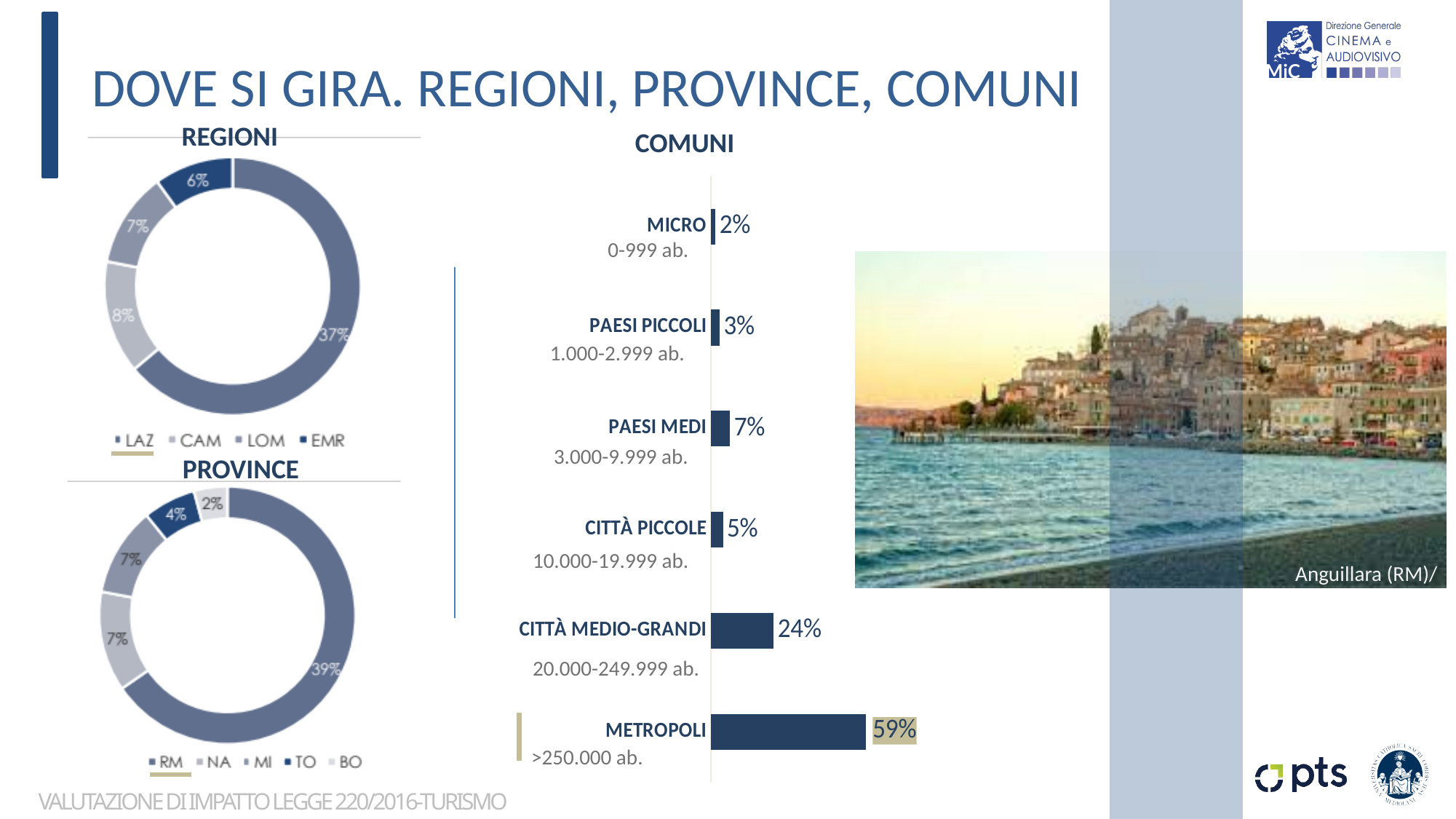
In the COMUNI chart, what is the value for CITTÀ MEDIO-GRANDI? 24% In the COMUNI chart, which is larger, PAESI MEDI or CITTÀ PICCOLE? PAESI MEDI How many categories does the COMUNI chart show? 6 In the COMUNI chart, what is the value for METROPOLI? 59% In the COMUNI chart, which category has the highest value? METROPOLI In the COMUNI chart, what is the difference between the values for METROPOLI and CITTÀ MEDIO-GRANDI? 35% What kind of chart is the COMUNI chart? Bar chart How many entries does the legend of the PROVINCE chart list? 5 In the REGIONI chart, which is larger, CAM or EMR? CAM In the PROVINCE chart, what is the value for BO? 2% In the REGIONI chart, what is the value for LAZ? 37% In the COMUNI chart, which category has the lowest value? MICRO